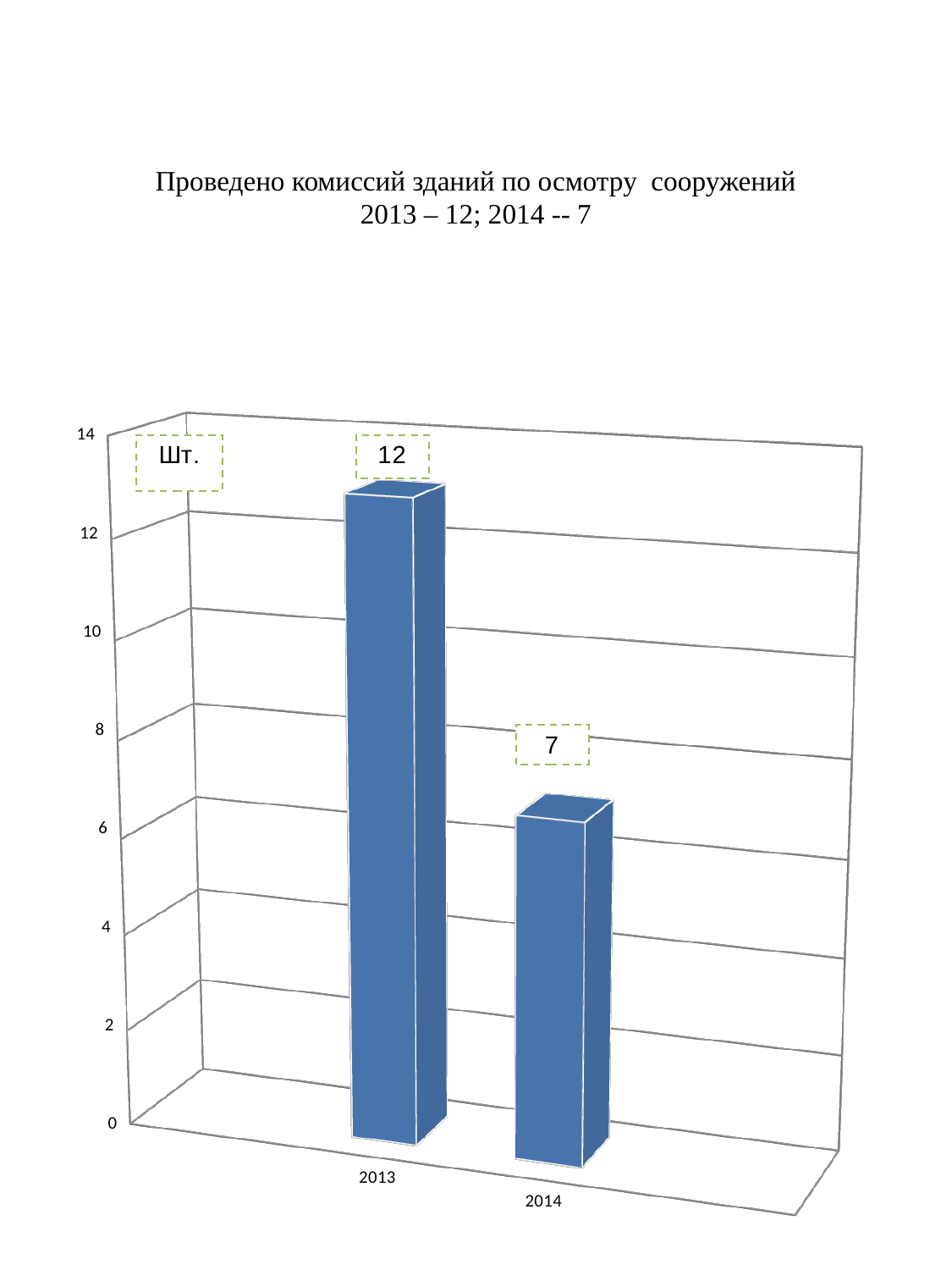
Is the value for 2013 greater or less than 10? greater What is the value for 2014? 7 Which year has the lowest value? 2014 How many categories are shown on the x axis? 2 What is the value for 2013? 12 What unit label is shown in the box at the top left of the chart? Шт. Is the value for 2014 greater or less than 10? less Which is larger, the value for 2013 or the value for 2014? 2013 What is the difference between the values for 2013 and 2014? 5 What kind of chart is shown on the slide? bar chart Which year has the highest value? 2013 Do the values rise or fall from 2013 to 2014? fall